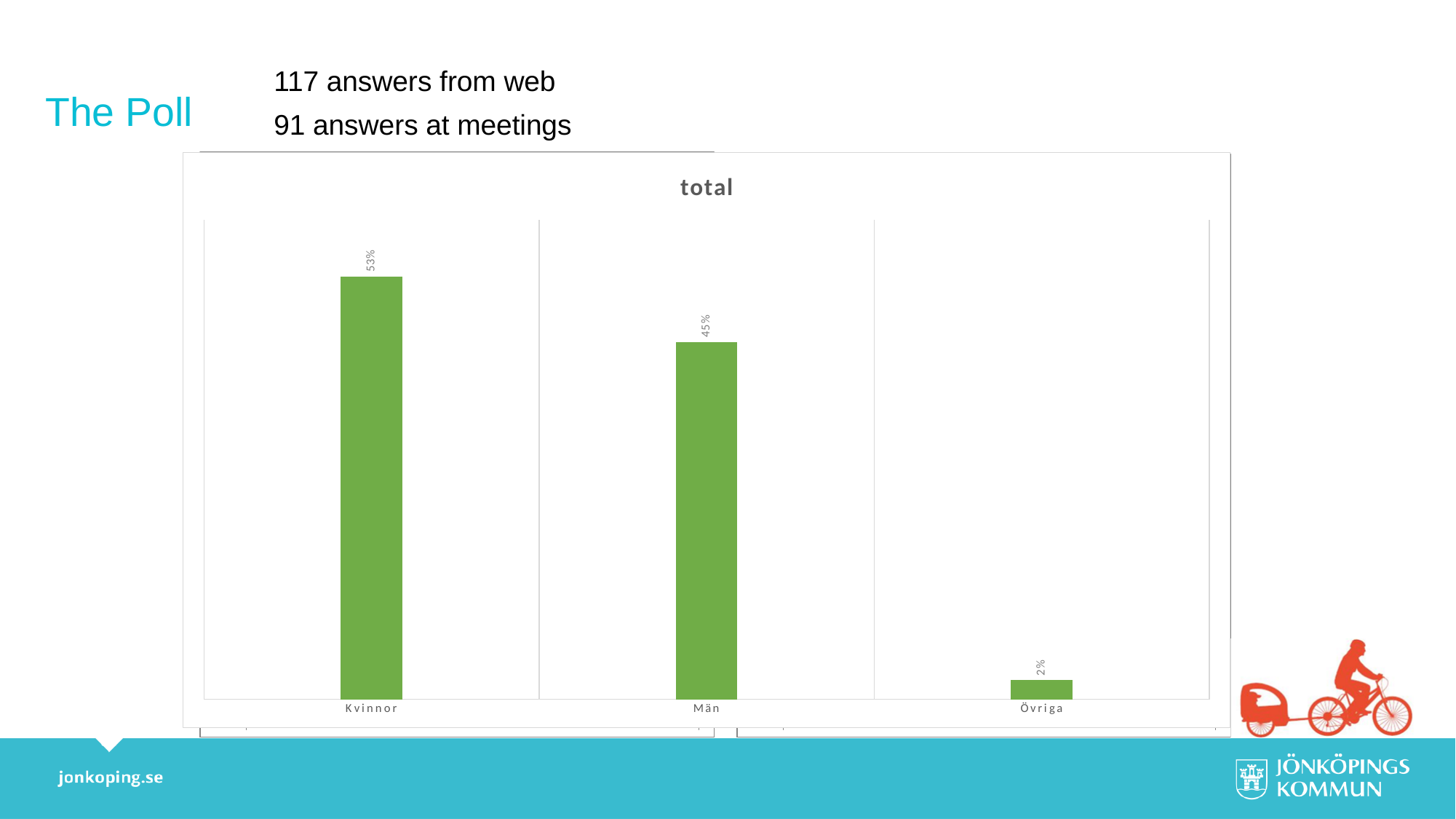
Which category has the lowest value? Övriga What is the value for Män? 45% What is the difference between the values for Kvinnor and Män? 8% Which category has the highest value? Kvinnor How many categories are shown on the chart? 3 Do the values rise or fall from left to right across the categories? fall What kind of chart is shown on the slide? bar chart What is the value for Övriga? 2% What is the value for Kvinnor? 53% What is the title of the chart? total Which is larger, the value for Kvinnor or the value for Män? Kvinnor What is the difference between the values for Män and Övriga? 43%